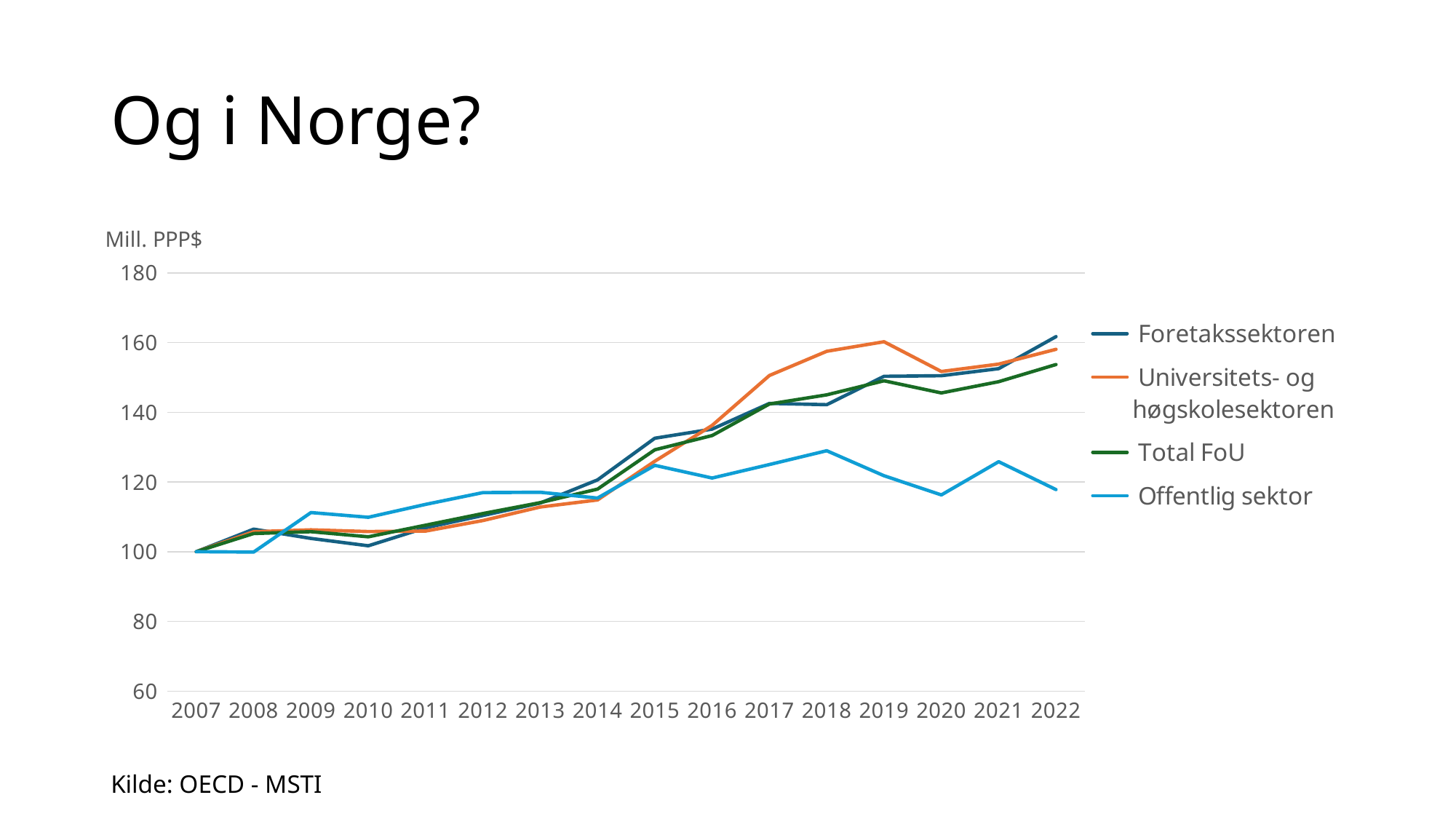
Is the value for Offentlig sektor in 2020 greater or less than 120? less Which series has the highest value in 2022? Foretakssektoren What is the value for Total FoU in 2007? 100 What kind of chart is shown on the slide? line chart Is the value for Total FoU in 2020 greater or less than 140? greater Which series has the lowest value in 2022? Offentlig sektor Is the value for Foretakssektoren in 2015 greater or less than 120? greater What unit label is shown above the y axis? Mill. PPP$ In 2019, which is larger: Universitets- og høgskolesektoren or Offentlig sektor? Universitets- og høgskolesektoren Does the Foretakssektoren line rise or fall overall from 2007 to 2022? rise How many series does the legend list? 4 How many years are shown on the x axis? 16